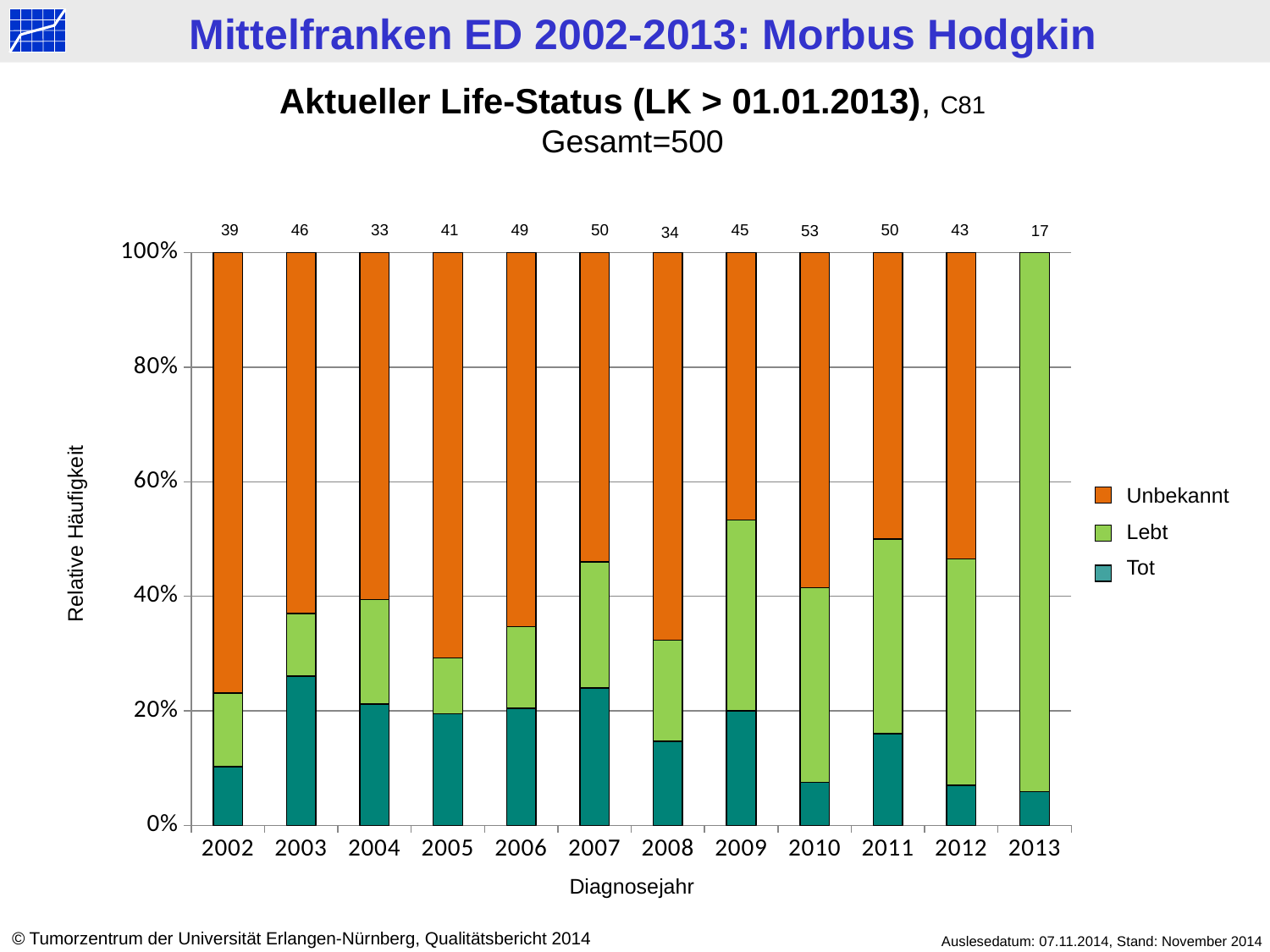
What kind of chart is shown on the slide? Stacked bar chart What is the difference between the numbers printed above the bars for 2003 and 2004? 13 Which has a larger number printed above its bar, 2006 or 2008? 2006 How many diagnosis years are shown on the x axis? 12 Which diagnosis year has the highest number printed above its bar? 2010 Which diagnosis year has the lowest number printed above its bar? 2013 Is the value for Lebt in 2013 greater or less than 80%? greater Is the value for Tot in 2003 greater or less than 20%? greater What number is printed above the bar for 2010? 53 How many series does the legend list? 3 Is the value for Tot in 2010 greater or less than 20%? less What number is printed above the bar for 2013? 17